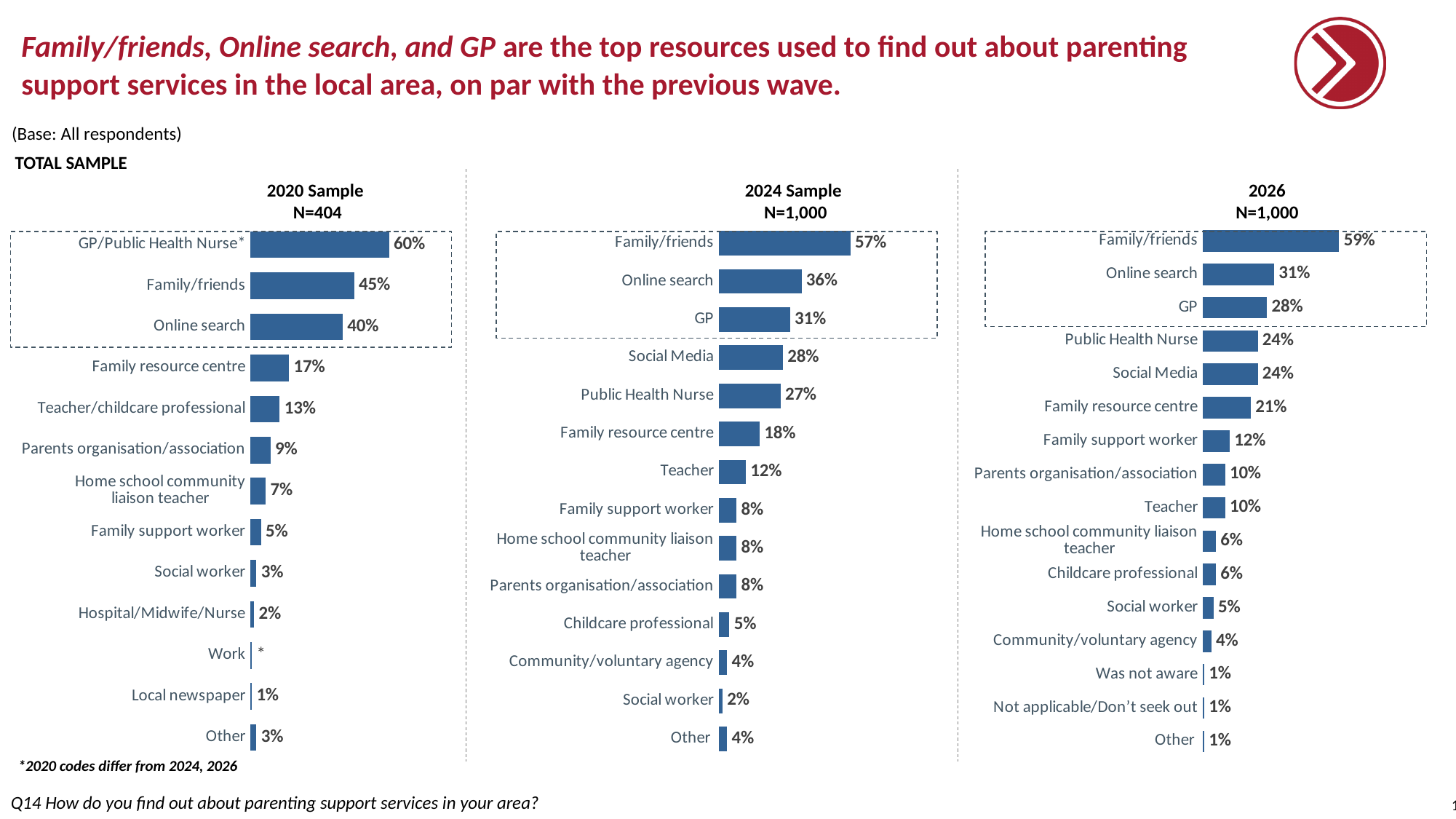
In the 2026 chart, which category has the highest value? Family/friends How many categories are shown in the 2026 chart? 16 In the 2026 chart, what is the difference between Online search and GP? 3% How many categories are shown in the 2024 Sample chart? 14 In the 2020 Sample chart, what is the value for GP/Public Health Nurse? 60% In the 2020 Sample chart, which is larger: Family resource centre or Teacher/childcare professional? Family resource centre In the 2024 Sample chart, which category has the lowest value? Social worker In the 2024 Sample chart, what is the value for Social Media? 28% In the 2026 chart, what is the value for Family resource centre? 21% What type of chart is the 2020 Sample chart? Bar chart In the 2024 Sample chart, what is the difference between Family/friends and Online search? 21% What is the sample size (N) shown for the 2020 Sample chart? N=404